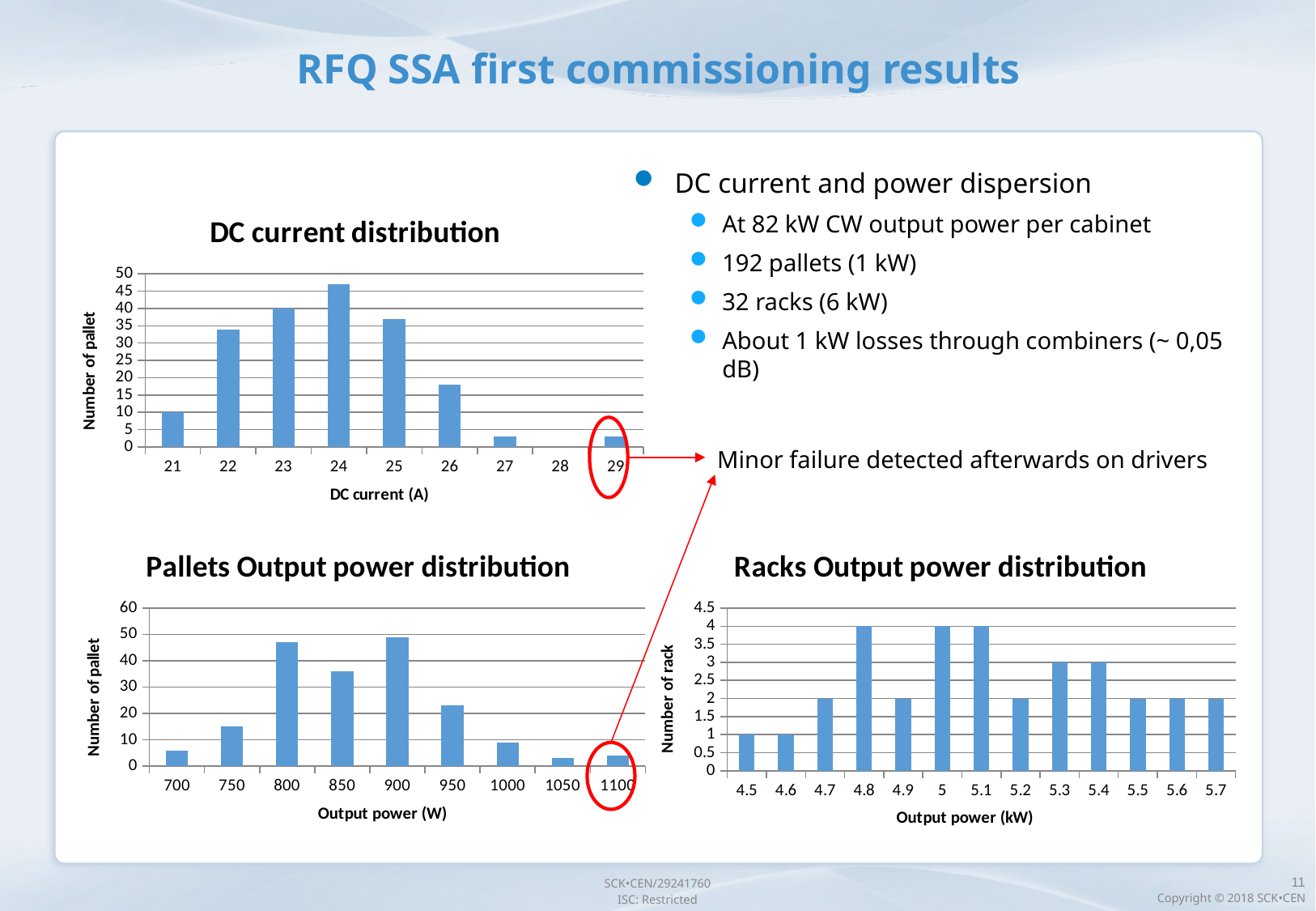
In the DC current distribution chart, which has more pallets: 23 A or 25 A? 23 A In the Racks Output power distribution chart, what is the difference between the number of racks at 4.8 kW and at 4.9 kW? 2 In the DC current distribution chart, is the number of pallets at 22 A greater or less than 30? greater How many DC current categories are shown on the x axis of the DC current distribution chart? 9 In the Racks Output power distribution chart, what is the number of racks at 4.5 kW? 1 In the DC current distribution chart, which DC current value has the highest number of pallets? 24 In the Racks Output power distribution chart, what is the number of racks at 5.3 kW? 3 In the Pallets Output power distribution chart, which output power value has the highest number of pallets? 900 In the DC current distribution chart, is the number of pallets at 26 A greater or less than 20? less In the Pallets Output power distribution chart, is the number of pallets at 850 W greater or less than 30? greater In the Pallets Output power distribution chart, which has more pallets: 750 W or 950 W? 950 W What type of chart is the Pallets Output power distribution chart? bar chart